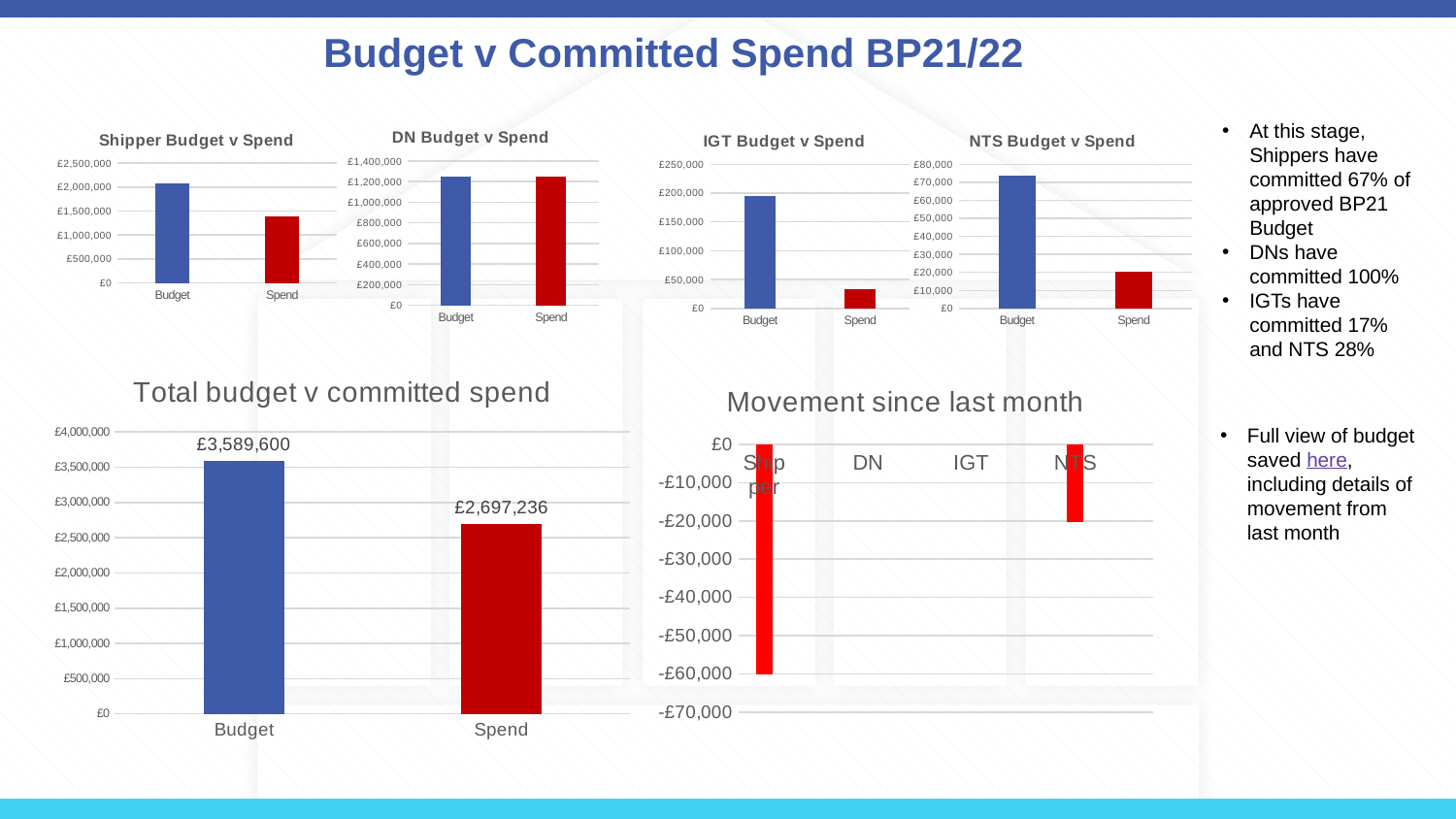
In the 'IGT Budget v Spend' chart, is the value for Budget greater or less than £150,000? greater In the 'Shipper Budget v Spend' chart, which is larger, Budget or Spend? Budget In the 'Shipper Budget v Spend' chart, is the value for Spend greater or less than £1,500,000? less How many small 'Budget v Spend' charts are shown across the top of the slide? 4 In the 'Total budget v committed spend' chart, what is the difference between Budget and Spend? £892,364 In the 'Total budget v committed spend' chart, what is the value for Spend? £2,697,236 In the 'Total budget v committed spend' chart, what is the value for Budget? £3,589,600 In the 'IGT Budget v Spend' chart, is the value for Spend greater or less than £50,000? less What kind of chart is the 'Total budget v committed spend' chart? bar chart In the 'Movement since last month' chart, which category shows the largest negative movement? Shipper How many categories are shown on the x axis of the 'Movement since last month' chart? 4